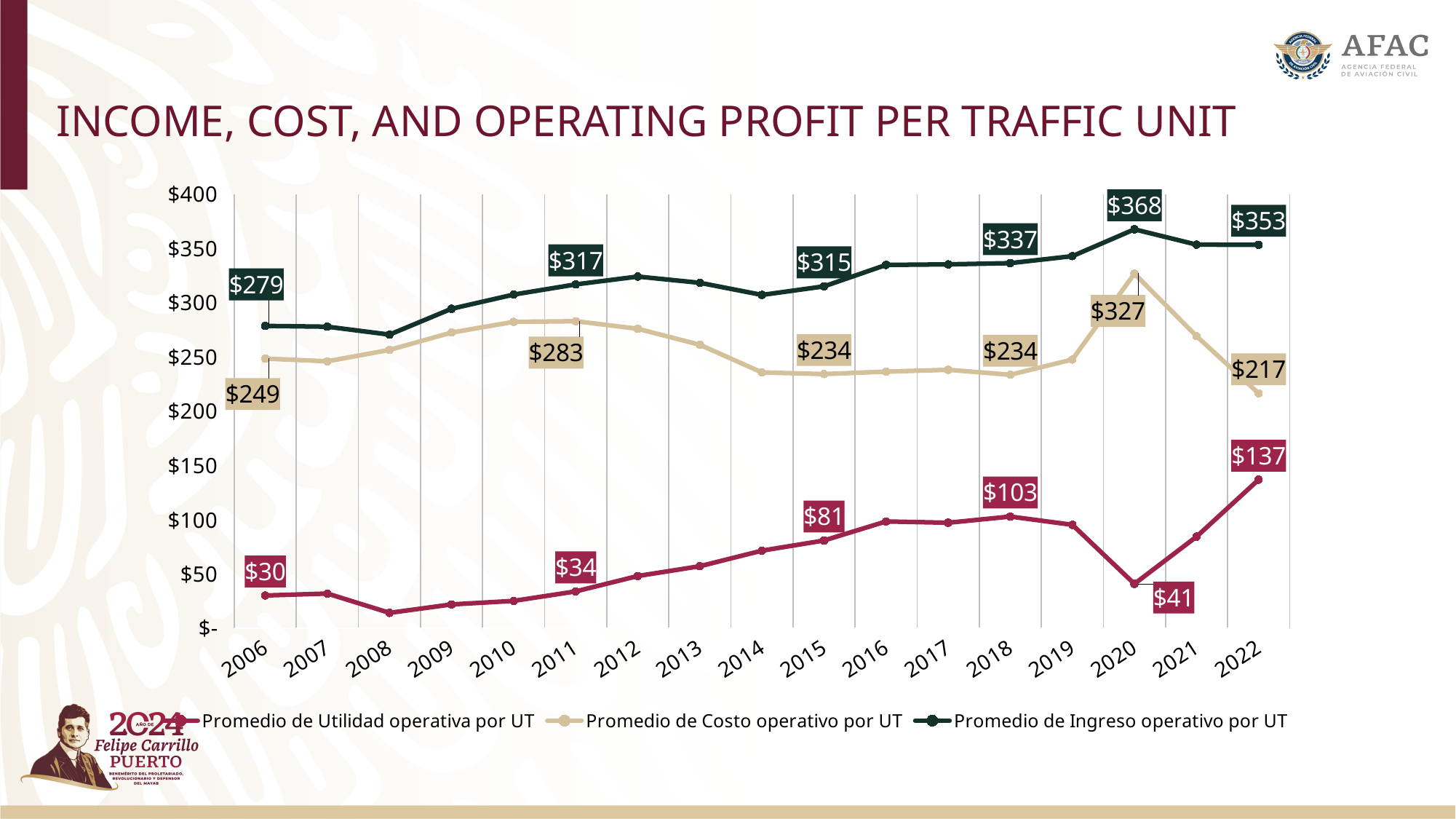
What is the difference between Promedio de Ingreso operativo por UT in 2020 and in 2022? $15 What is the value of Promedio de Ingreso operativo por UT in 2020? $368 What kind of chart is shown on the slide? line chart What is the value of Promedio de Utilidad operativa por UT in 2018? $103 By how much did Promedio de Utilidad operativa por UT increase from 2020 to 2022? $96 Which year has the higher Promedio de Costo operativo por UT, 2011 or 2020? 2020 Is the value of Promedio de Utilidad operativa por UT in 2016 greater or less than $50? greater How many series does the legend list? 3 How many years are shown on the x axis of the chart? 17 What is the value of Promedio de Costo operativo por UT in 2022? $217 Is the value of Promedio de Ingreso operativo por UT in 2008 greater or less than $300? less In which year is Promedio de Ingreso operativo por UT at its highest? 2020